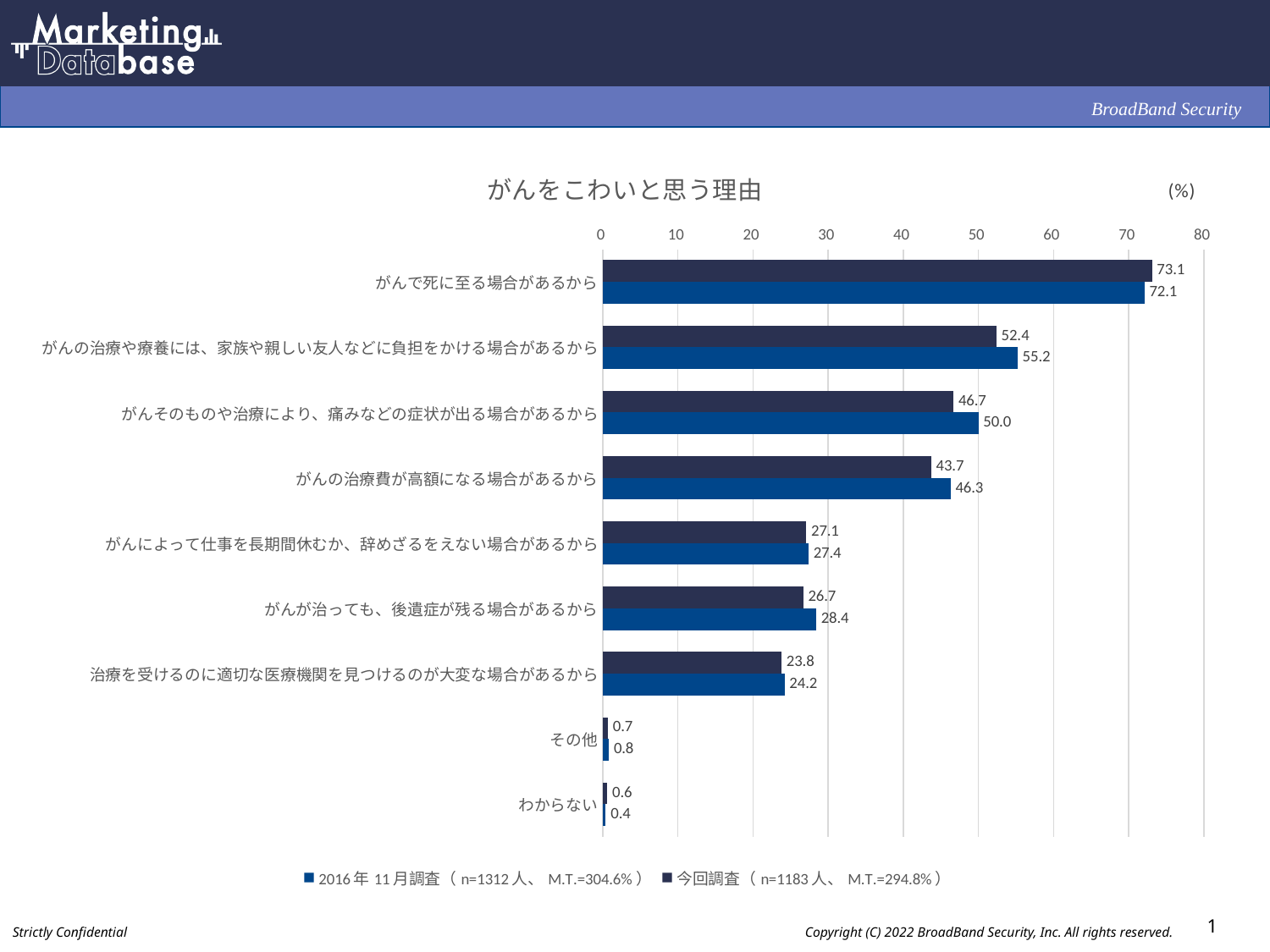
What kind of chart is shown on the slide? bar chart Which category has the lowest value in the 2016年11月調査 series? わからない What is the value for 「その他」 in the 今回調査 series? 0.7 For 「がんそのものや治療により、痛みなどの症状が出る場合があるから」, which series has the larger value, 2016年11月調査 or 今回調査? 2016年11月調査 What is the title of the chart? がんをこわいと思う理由 What is the difference between the 2016年11月調査 and 今回調査 values for 「がんの治療や療養には、家族や親しい友人などに負担をかける場合があるから」? 2.8 Which category has the highest value in the 今回調査 series? がんで死に至る場合があるから Is the 今回調査 value for 「がんが治っても、後遺症が残る場合があるから」 greater or less than 30? less How many series does the legend list? 2 What is the value for 「がんの治療費が高額になる場合があるから」 in the 2016年11月調査 series? 46.3 What is the value for 「がんで死に至る場合があるから」 in the 今回調査 series? 73.1 How many categories (reasons) are plotted on the chart? 9